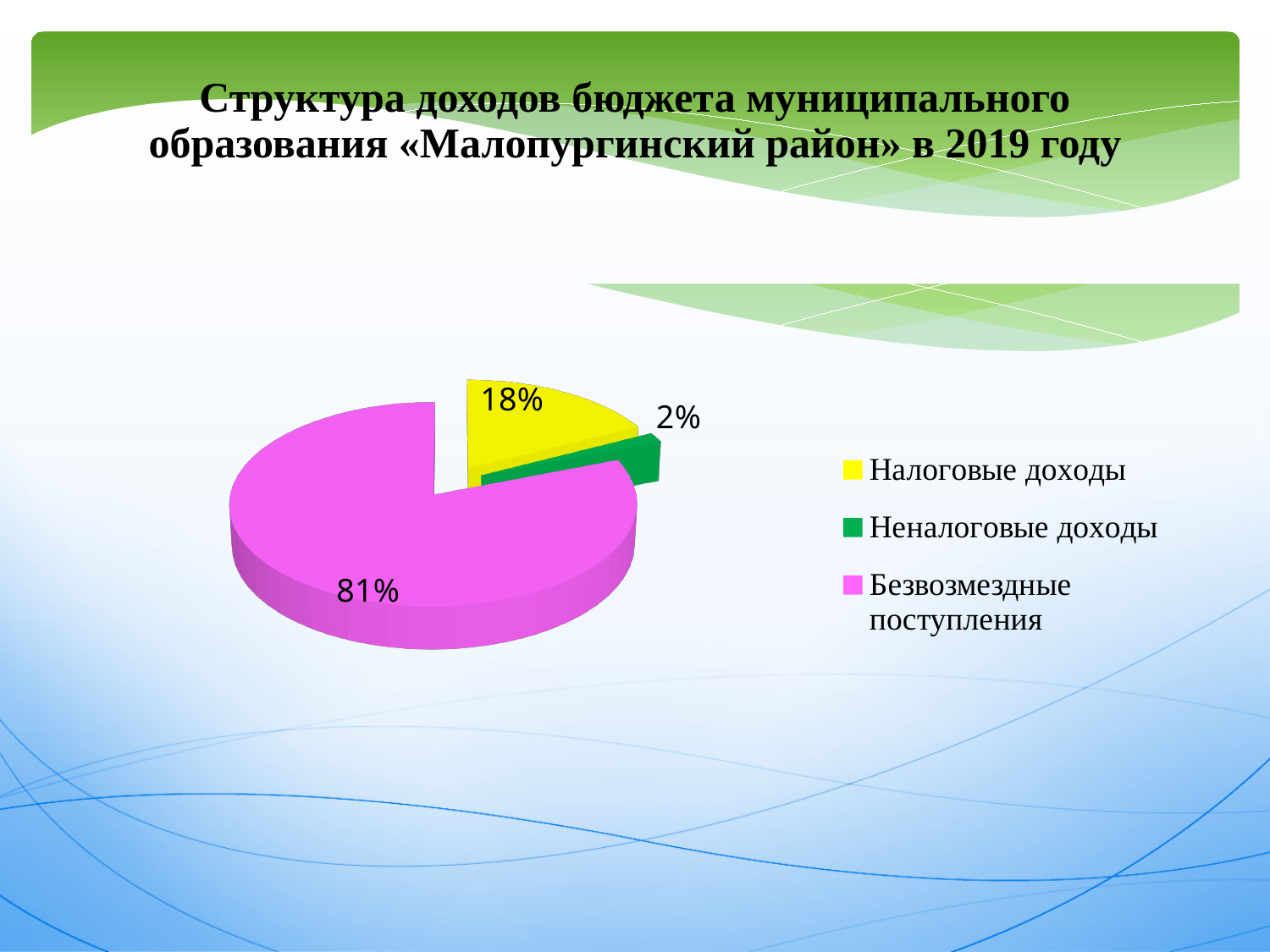
What is the difference in percentage points between Налоговые доходы and Неналоговые доходы? 16 Which is larger, Налоговые доходы or Неналоговые доходы? Налоговые доходы Which category has the largest slice of the pie? Безвозмездные поступления What is the title of the slide? Структура доходов бюджета муниципального образования «Малопургинский район» в 2019 году What is the difference in percentage points between Безвозмездные поступления and Налоговые доходы? 63 What colour is the slice for Безвозмездные поступления? Pink How many categories does the pie chart show? 3 Which category has the smallest slice of the pie? Неналоговые доходы What share of the pie is Безвозмездные поступления? 81% What share of the pie is Налоговые доходы? 18% What kind of chart is shown on the slide? Pie chart What share of the pie is Неналоговые доходы? 2%